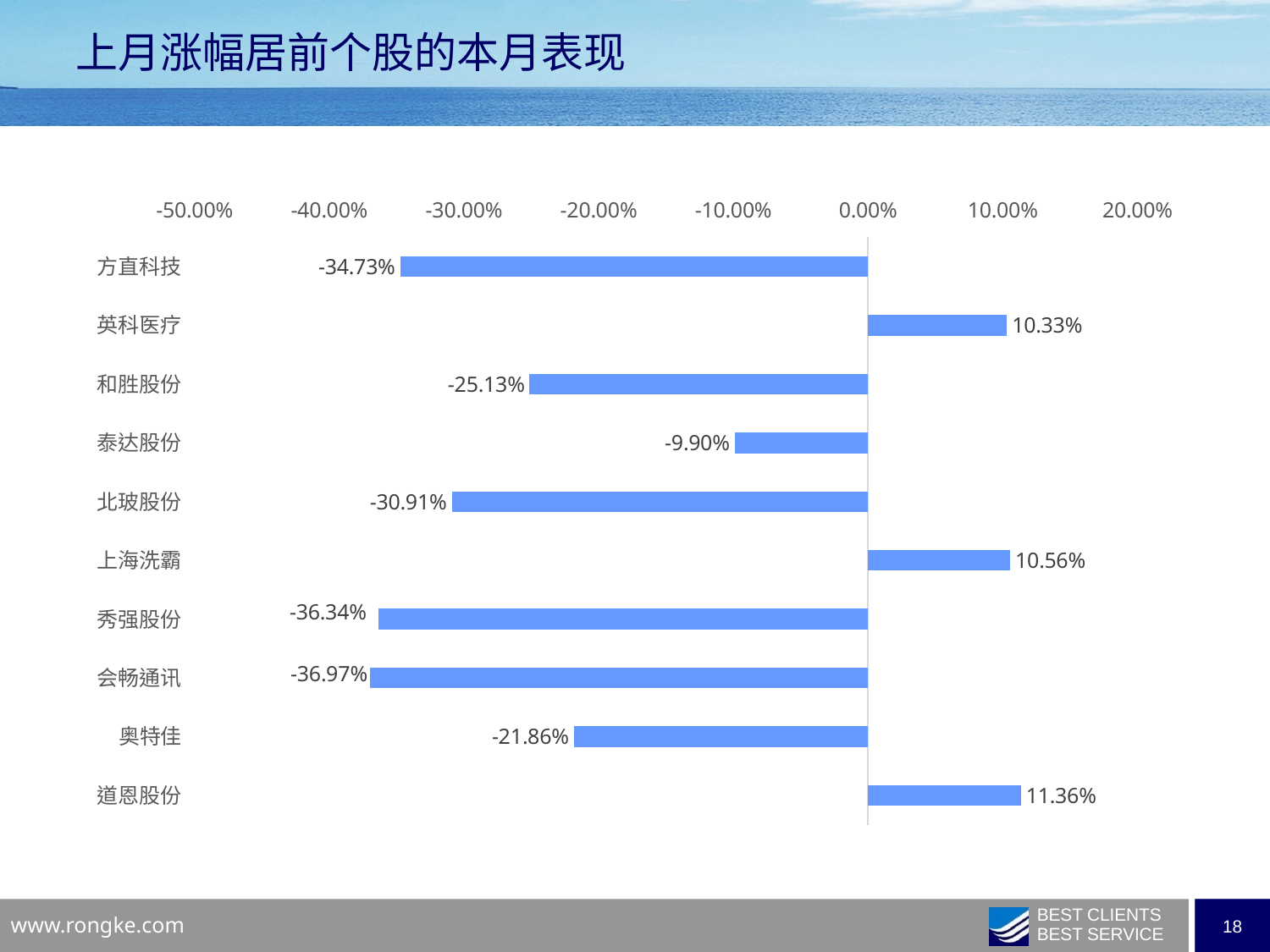
Which stock has the highest value? 道恩股份 What is the difference between the values for 道恩股份 and 英科医疗? 1.03 percentage points What is the title of the chart on the slide? 上月涨幅居前个股的本月表现 How many stocks are shown in the chart? 10 Is the value for 奥特佳 greater or less than -20.00%? less What is the value for 英科医疗? 10.33% Which is larger, the value for 上海洗霸 or the value for 英科医疗? 上海洗霸 What is the value for 方直科技? -34.73% What is the value for 泰达股份? -9.90% Which stock has the lowest value? 会畅通讯 What kind of chart is shown on the slide? bar chart What is the value for 奥特佳? -21.86%